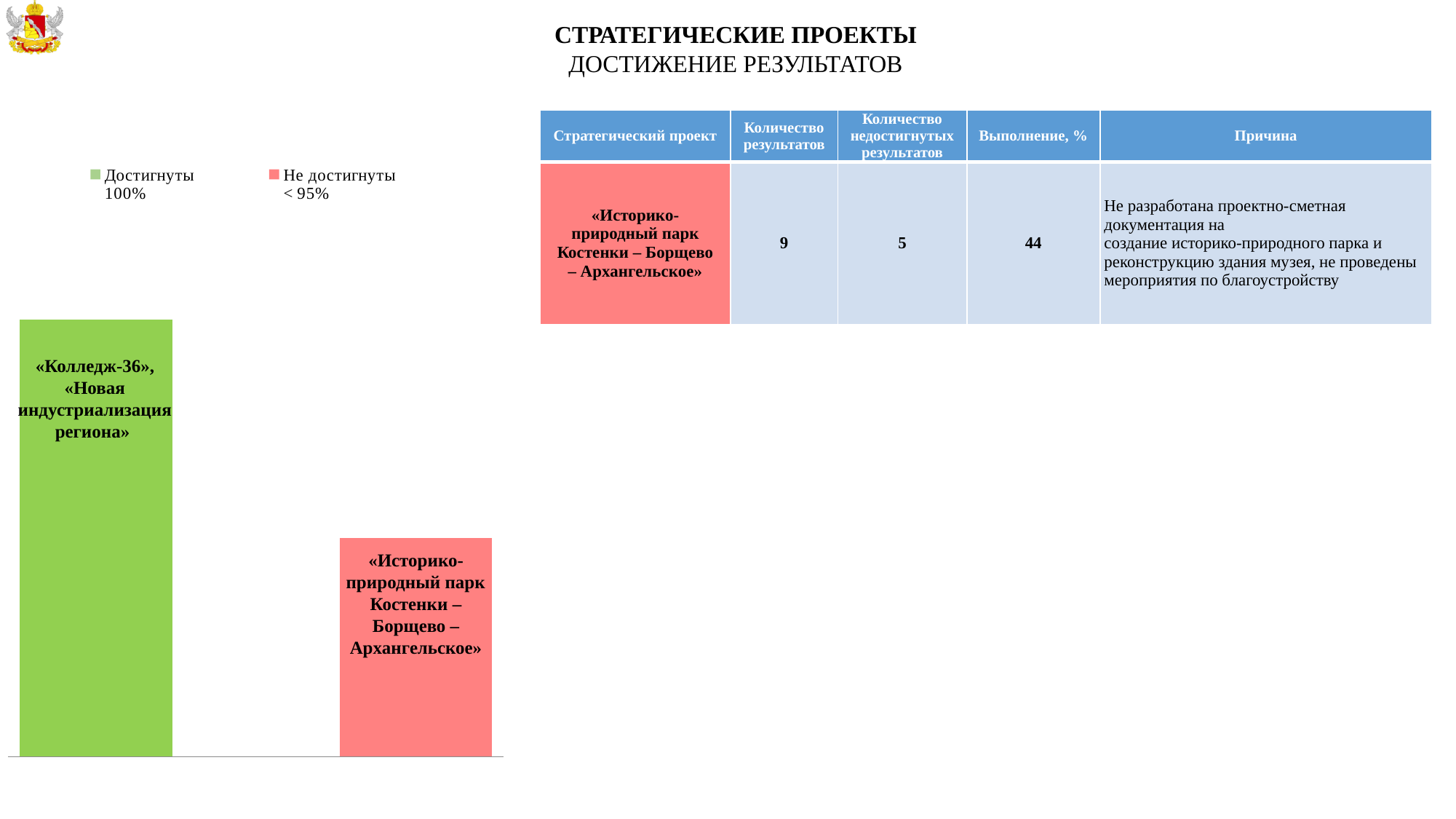
Which bar is taller in the chart: «Колледж-36», «Новая индустриализация региона» or «Историко-природный парк Костенки – Борщево – Архангельское»? «Колледж-36», «Новая индустриализация региона» Which bar in the chart is the highest? «Колледж-36», «Новая индустриализация региона» Which legend entry in the chart is shown in green? Достигнуты 100% How many entries does the legend of the chart list? 2 Which bar in the chart is the lowest? «Историко-природный парк Костенки – Борщево – Архангельское» What colour is the bar for «Историко-природный парк Костенки – Борщево – Архангельское» in the chart? red What kind of chart is shown on the left of the slide? bar chart How many bars does the chart on the left of the slide have? 2